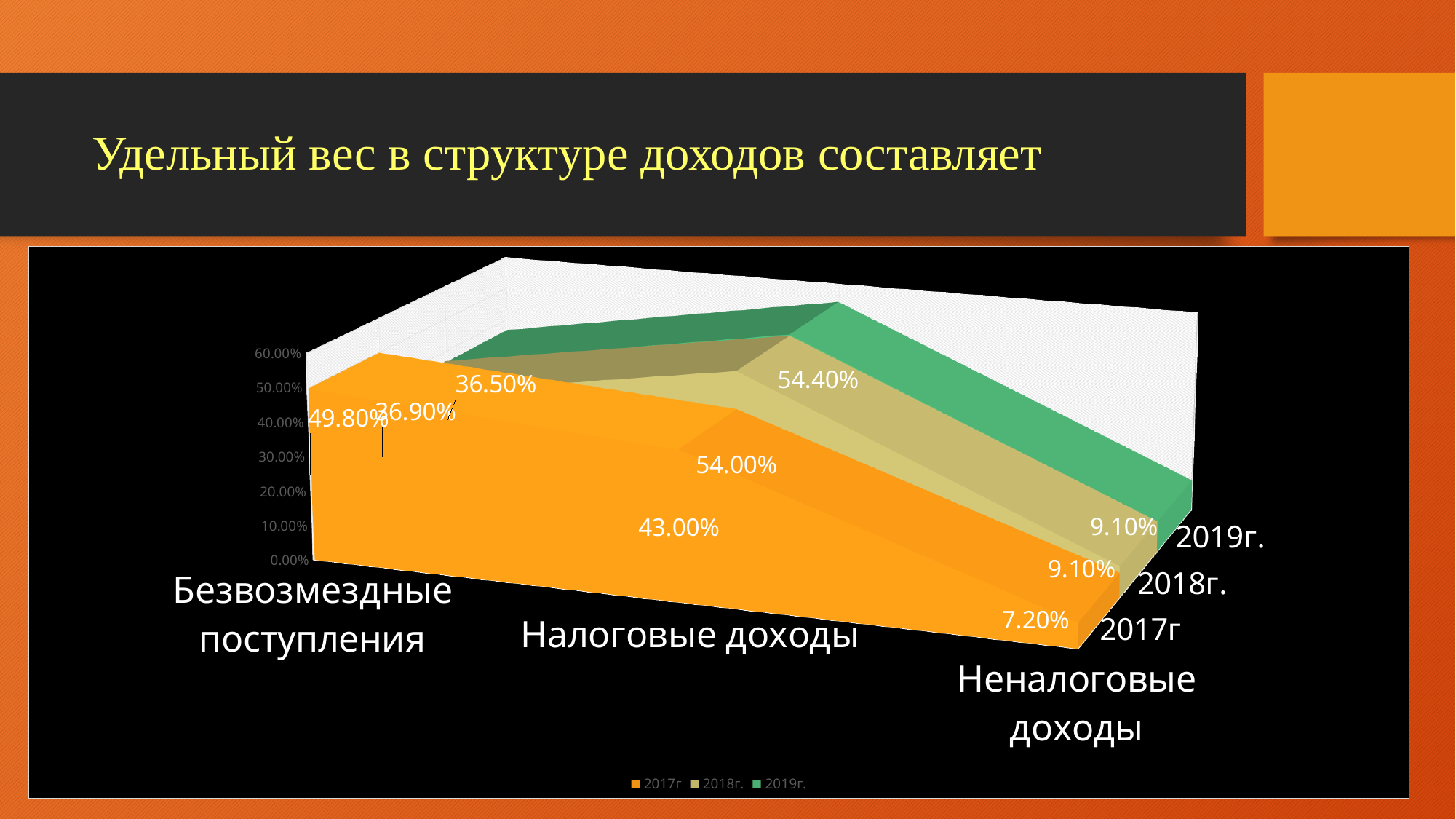
What is the value for Безвозмездные поступления in the 2017г series? 49.80% What kind of chart is shown on the slide? Area chart Which category has the lowest value in the 2017г series? Неналоговые доходы Which is larger for Безвозмездные поступления: the 2017г value or the 2019г. value? 2017г How many categories are shown on the x axis? 3 Which category has the highest value in the 2018г. series? Налоговые доходы What is the difference between the 2017г values for Безвозмездные поступления and Налоговые доходы? 6.80% What is the title of the slide? Удельный вес в структуре доходов составляет What is the value for Налоговые доходы in the 2019г. series? 54.40% How many series does the legend list? 3 What is the value for Налоговые доходы in the 2017г series? 43.00% What is the value for Неналоговые доходы in the 2019г. series? 9.10%